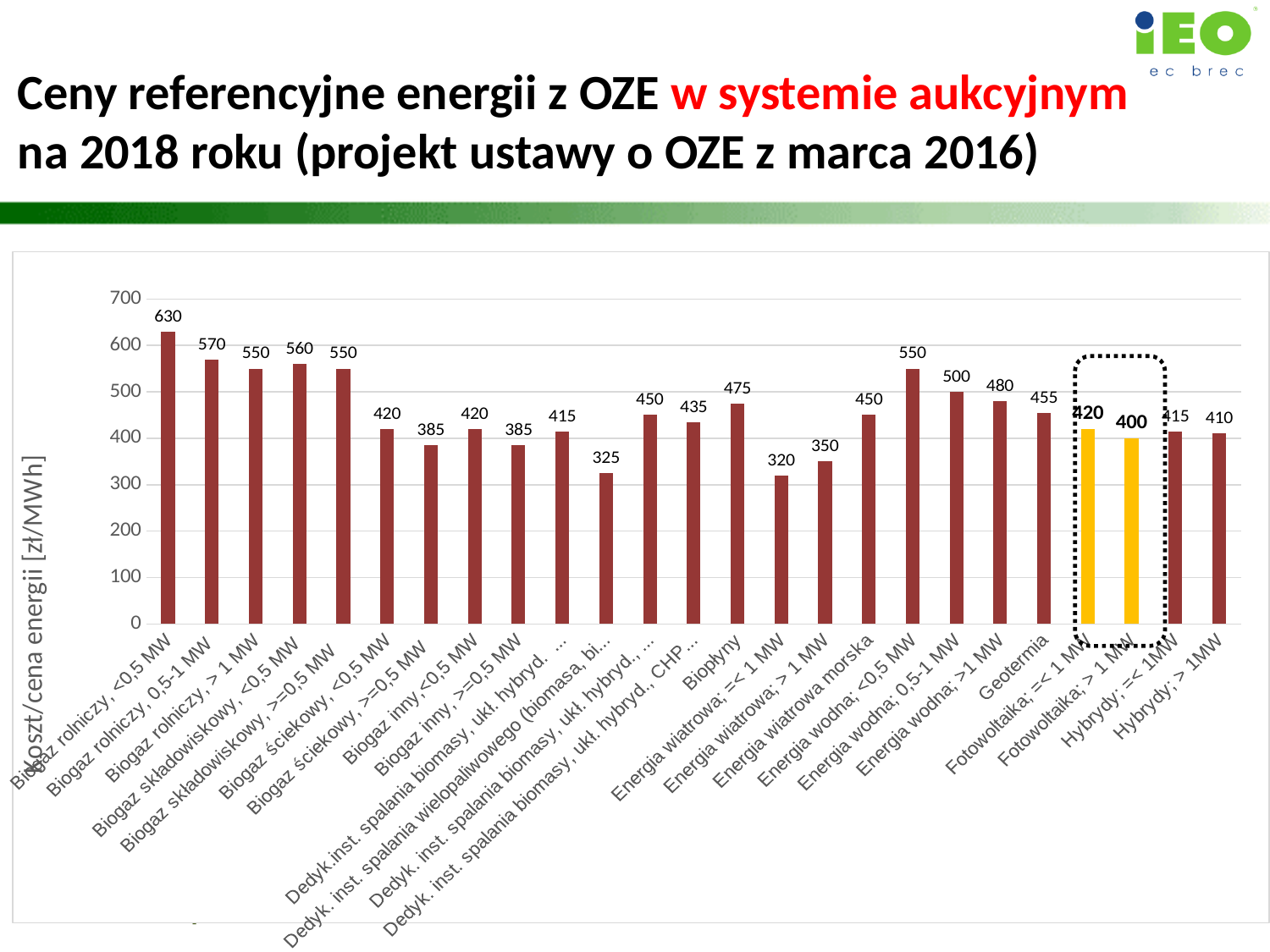
Which category has the highest value in the chart? Biogaz rolniczy, <0,5 MW What is the value shown for Geotermia? 455 Which is larger, the value for Fotowoltaika; =< 1 MW or the value for Fotowoltaika; > 1 MW? Fotowoltaika; =< 1 MW What is the reference price for Biopłyny? 475 What is the value for Fotowoltaika; > 1 MW? 400 What type of chart is shown on the slide? bar chart What is the label of the vertical axis? Koszt/cena energii [zł/MWh] Is the value for Energia wiatrowa; > 1 MW greater or less than 400? less What is the value for Energia wiatrowa morska? 450 Which category has the lowest value in the chart? Energia wiatrowa; =< 1 MW What is the difference between the values for Energia wodna; <0,5 MW and Energia wodna; >1 MW? 70 How many categories (bars) are shown in the chart? 25